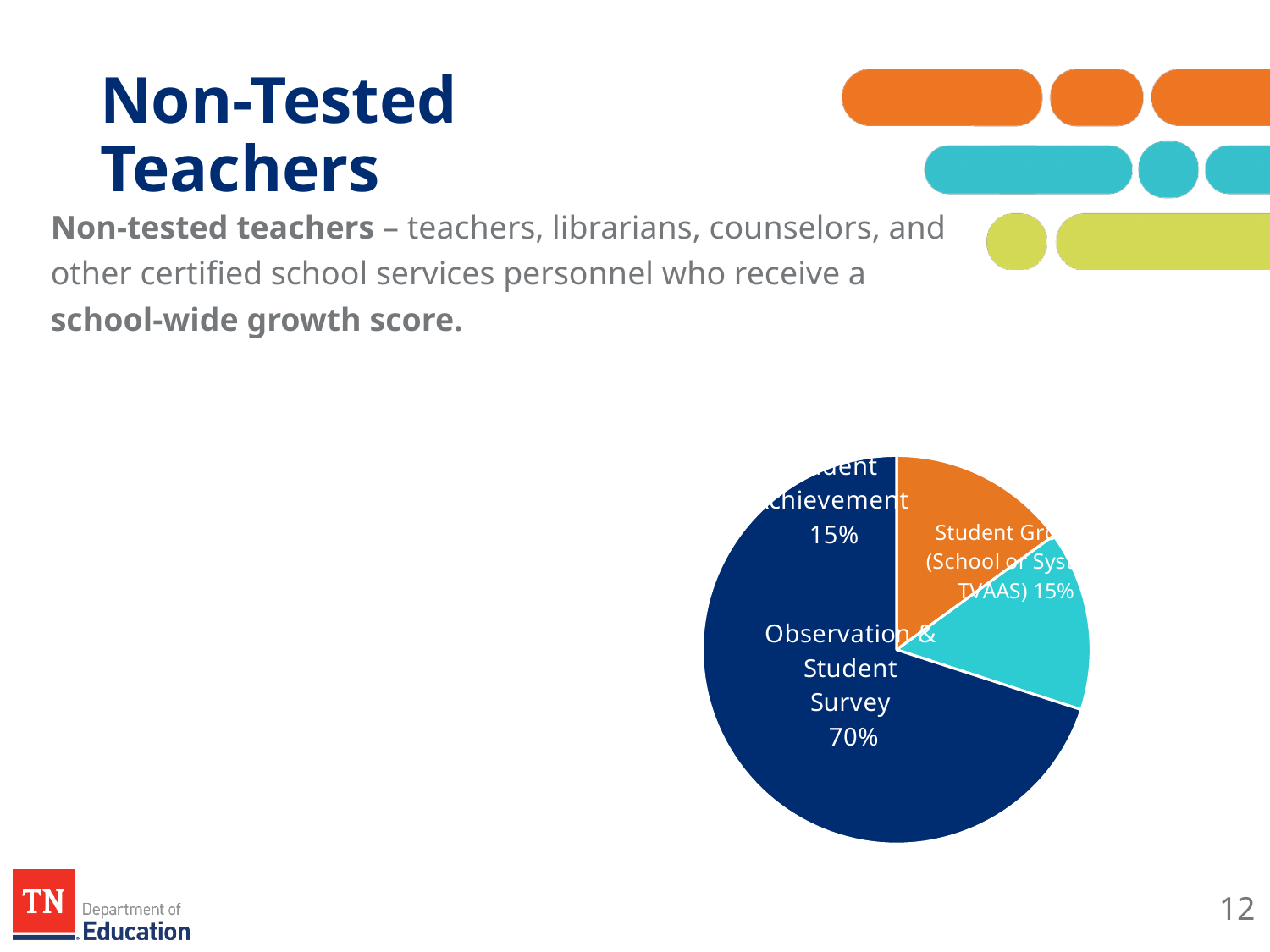
What share of the pie does Observation & Student Survey make up? 70% What do the three slices of the pie chart add up to? 100% What is the difference between the Observation & Student Survey share and the Student Achievement share? 55% Is the Observation & Student Survey share greater or less than 50%? greater What percentage is shown for Student Growth (School or System TVAAS)? 15% What kind of chart is shown on the slide? pie chart What percentage is shown for Student Achievement? 15% What percentage does the Observation & Student Survey slice represent? 70% Which slice of the pie chart is the largest? Observation & Student Survey Which is larger, the Observation & Student Survey slice or the Student Achievement slice? Observation & Student Survey What colour is the Observation & Student Survey slice? dark blue How many slices does the pie chart have? 3